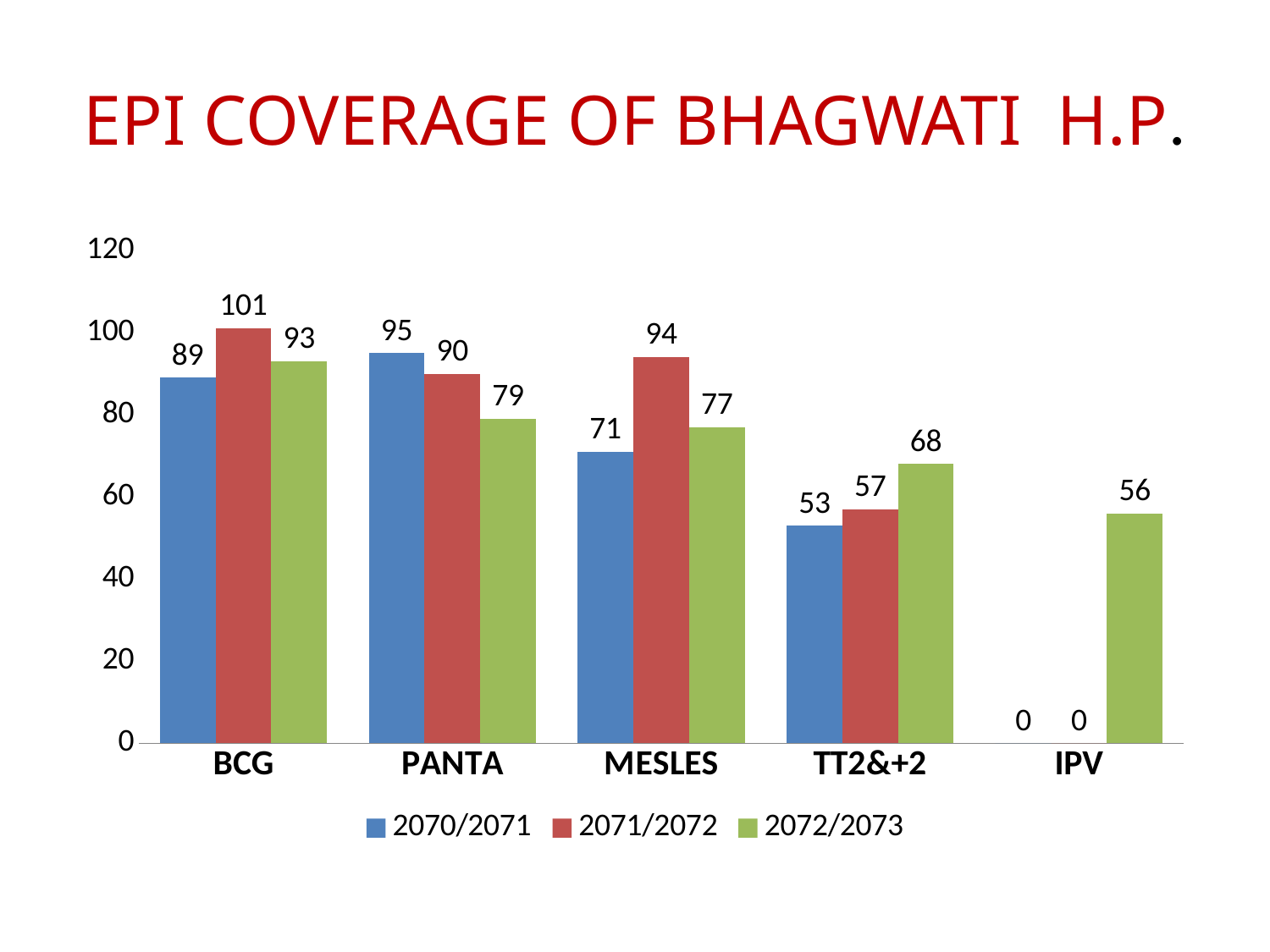
Which category has the lowest value in the 2072/2073 series? IPV What is the value for BCG in the 2071/2072 series? 101 What is the value for MESLES in the 2070/2071 series? 71 How many categories are shown on the x axis? 5 How many series does the legend list? 3 What kind of chart is shown on the slide? bar chart What is the difference between the 2071/2072 and 2070/2071 values for MESLES? 23 Is the value for PANTA in the 2072/2073 series greater or less than 80? less Which is larger for TT2&+2: the 2072/2073 value or the 2070/2071 value? 2072/2073 Which category has the highest value in the 2070/2071 series? PANTA What is the value for IPV in the 2072/2073 series? 56 What is the title of the slide? EPI COVERAGE OF BHAGWATI H.P.